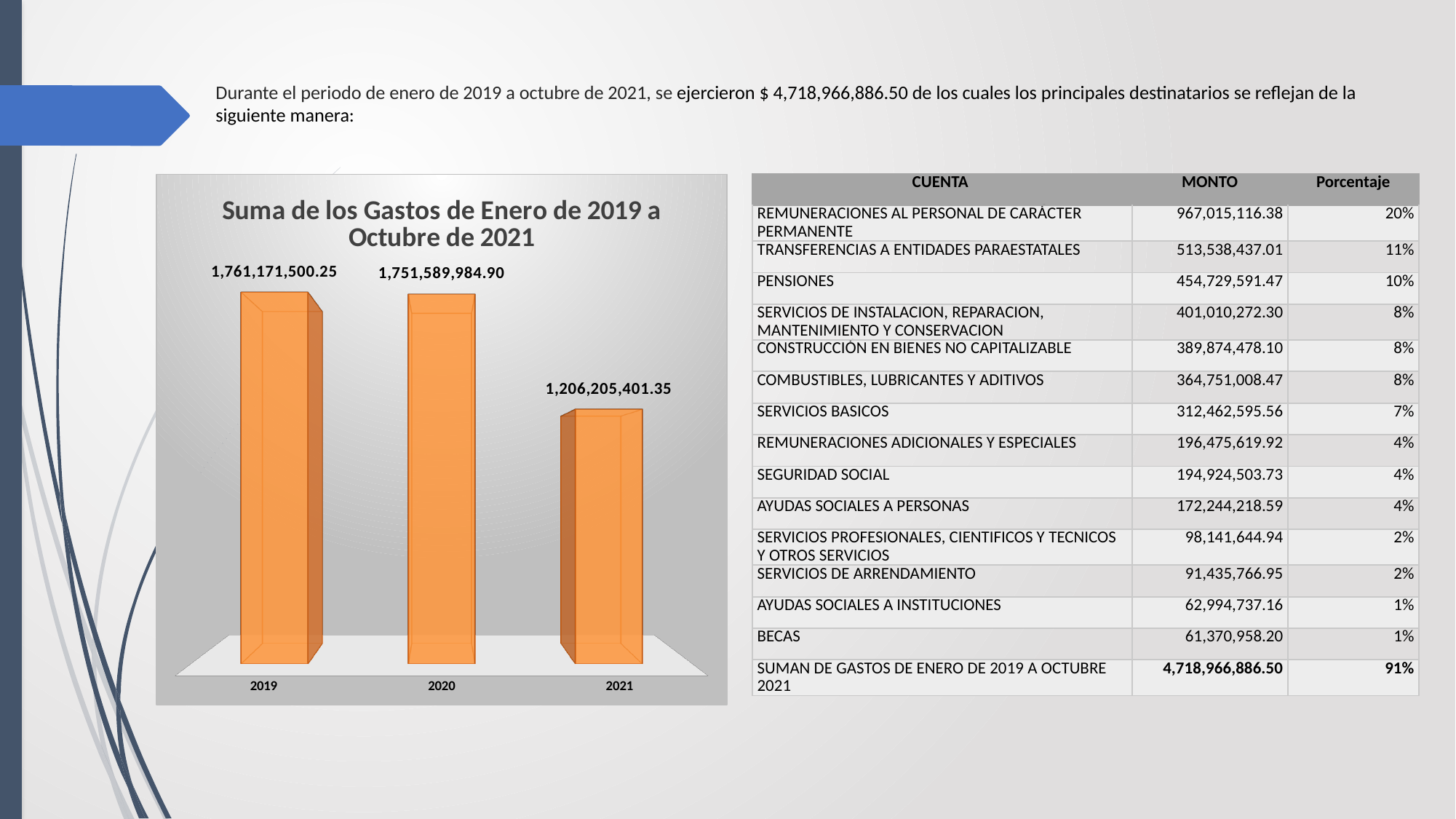
How many bars (years) are plotted in the chart? 3 What is the difference between the 2020 value and the 2021 value in the chart? 545,384,583.55 Which year has the lowest value in the chart? 2021 What is the value shown for 2020 in the chart? 1,751,589,984.90 What is the value shown for 2019 in the chart? 1,761,171,500.25 Do the values in the chart rise or fall from 2019 to 2021? fall What is the difference between the 2019 value and the 2020 value in the chart? 9,581,515.35 Which year has the highest value in the chart? 2019 What is the title of the chart? Suma de los Gastos de Enero de 2019 a Octubre de 2021 What type of chart is shown on the slide? bar chart Is the value for 2020 larger or smaller than the value for 2021? larger What is the value shown for 2021 in the chart? 1,206,205,401.35